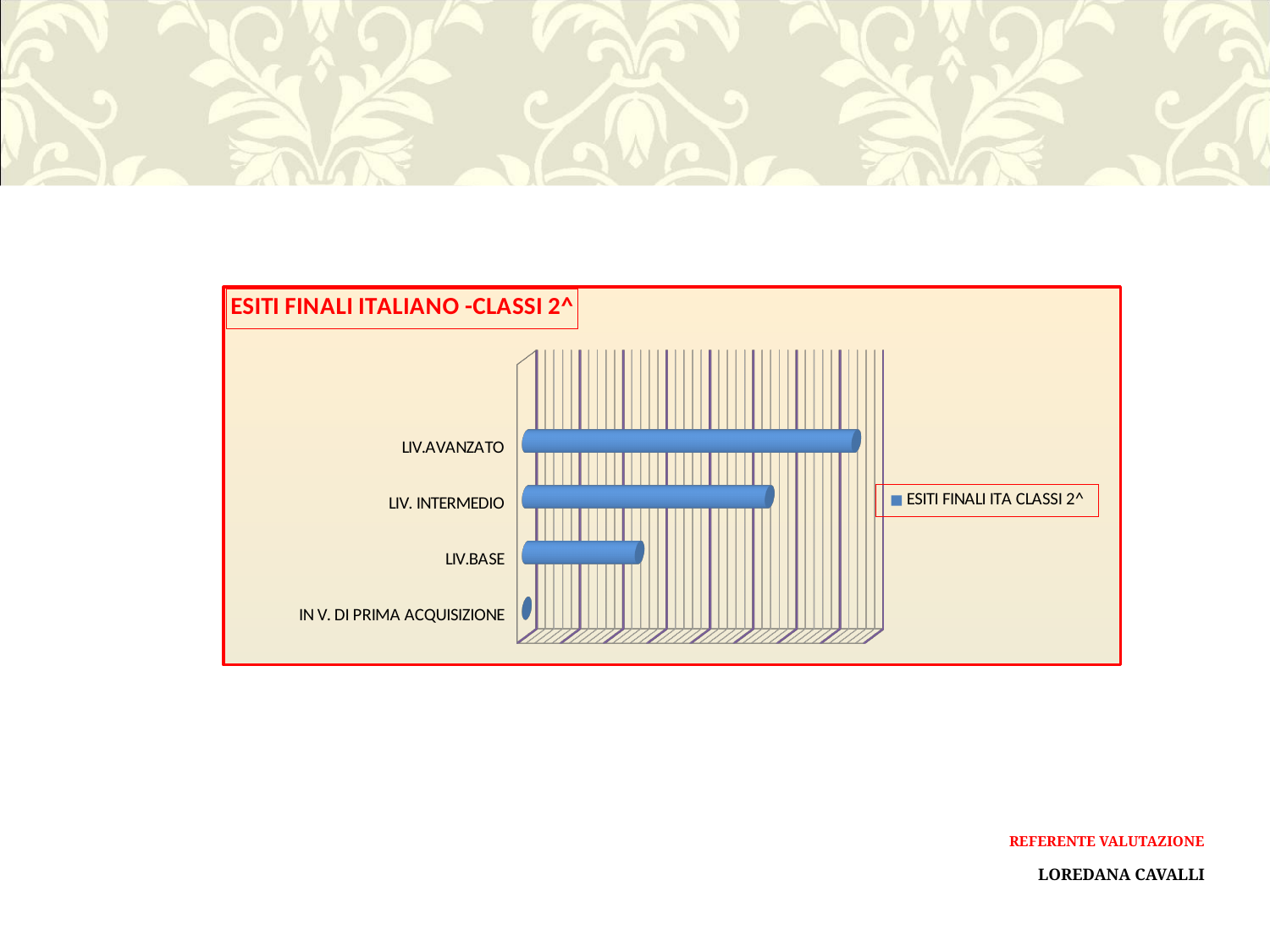
What is the title of the chart? ESITI FINALI ITALIANO -CLASSI 2^ How many series does the legend list? 1 What kind of chart is shown on the slide? Bar chart Which is larger, the value for LIV.AVANZATO or the value for LIV. INTERMEDIO? LIV.AVANZATO Which category has the highest value? LIV.AVANZATO Which is larger, the value for LIV.BASE or the value for IN V. DI PRIMA ACQUISIZIONE? LIV.BASE How many categories are plotted in the chart? 4 Which is larger, the value for LIV. INTERMEDIO or the value for LIV.BASE? LIV. INTERMEDIO What is the name of the series shown in the legend? ESITI FINALI ITA CLASSI 2^ Do the bar values rise or fall going from LIV.AVANZATO at the top down to IN V. DI PRIMA ACQUISIZIONE at the bottom? Fall Which category has the lowest value? IN V. DI PRIMA ACQUISIZIONE